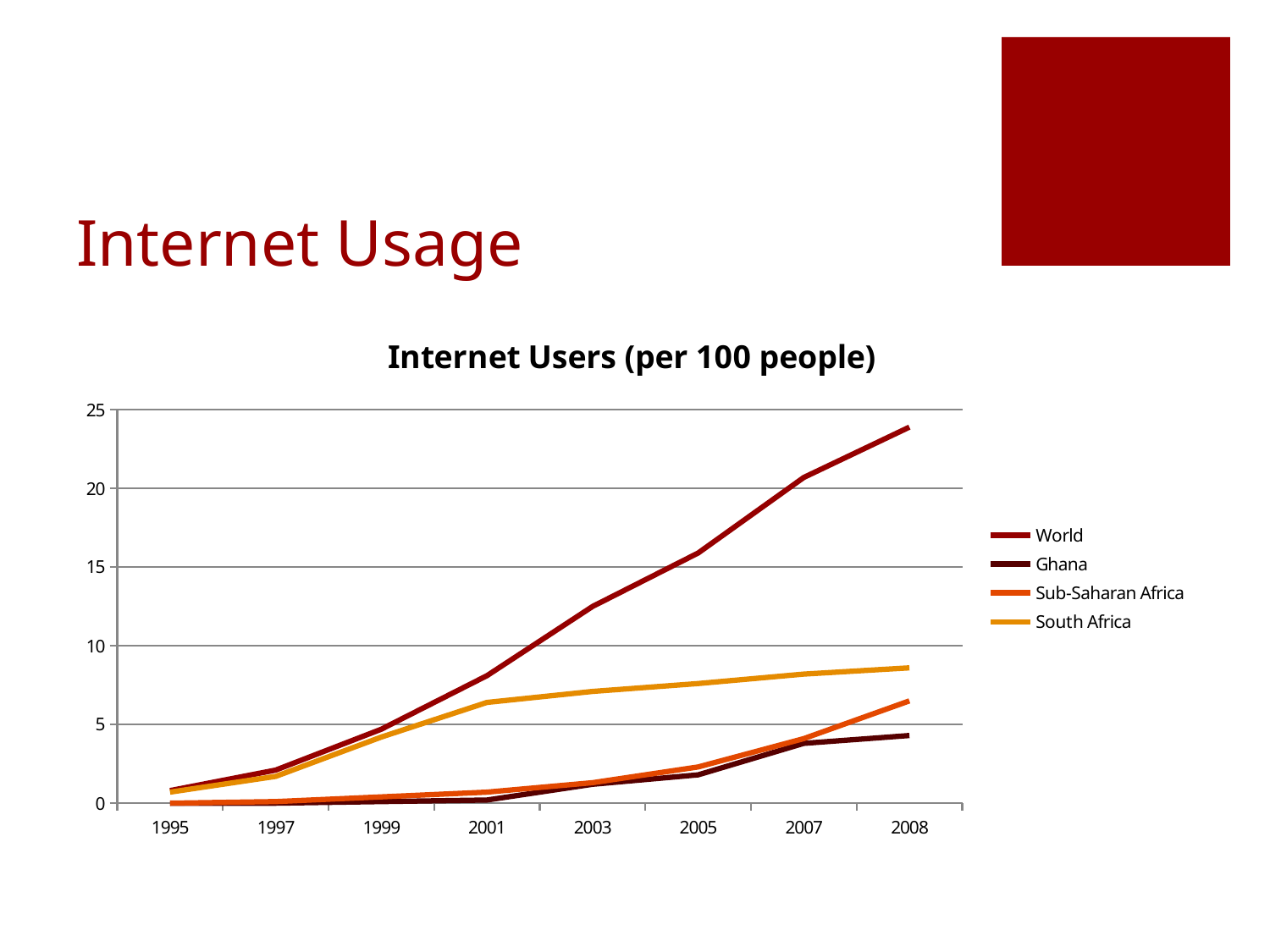
Is the value for World in 2008 greater or less than 20? greater Is the value for Ghana in 2008 greater or less than 5? less What kind of chart is shown on the slide? line chart Which series has the highest value in 2008? World Is the value for South Africa in 2008 greater or less than 10? less How many series does the legend list? 4 Which series has the lowest value in 2008? Ghana How many years are marked along the x axis? 8 In 2005, which is larger: the value for South Africa or the value for Sub-Saharan Africa? South Africa Does the World series rise or fall from 1995 to 2008? rise What is the title of the chart? Internet Users (per 100 people)